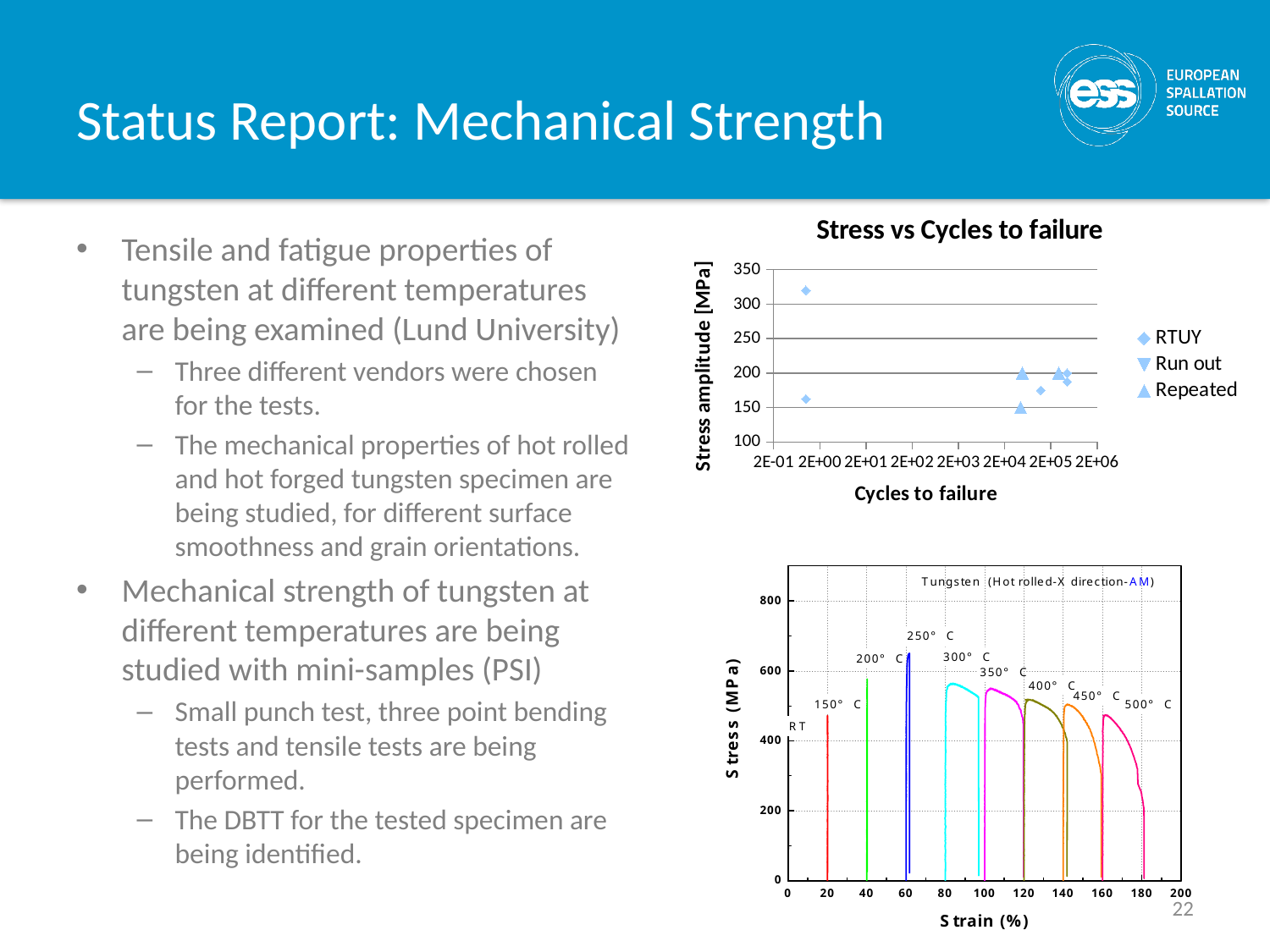
In the bottom 'Tungsten (Hot rolled-X direction-AM)' chart, which curve reaches a higher peak stress, 250° C or 500° C? 250° C In the bottom 'Tungsten (Hot rolled-X direction-AM)' chart, is the peak stress of the RT curve greater or less than 600? less In the bottom 'Tungsten (Hot rolled-X direction-AM)' chart, which temperature curve reaches the largest strain? 500° C What is the y-axis title of the 'Stress vs Cycles to failure' chart? Stress amplitude [MPa] What kind of chart is the bottom chart titled 'Tungsten (Hot rolled-X direction-AM)'? line chart In the bottom 'Tungsten (Hot rolled-X direction-AM)' chart, is the peak stress of the 250° C curve greater or less than 600? greater In the 'Stress vs Cycles to failure' chart, is the highest RTUY point greater or less than 300? greater How many stress-strain curves are plotted in the bottom 'Tungsten (Hot rolled-X direction-AM)' chart? 9 What are the legend entries of the 'Stress vs Cycles to failure' chart? RTUY, Run out, Repeated How many series does the legend of the 'Stress vs Cycles to failure' chart list? 3 What kind of chart is the 'Stress vs Cycles to failure' chart? scatter chart In the bottom 'Tungsten (Hot rolled-X direction-AM)' chart, which temperature curve reaches the highest stress? 250° C